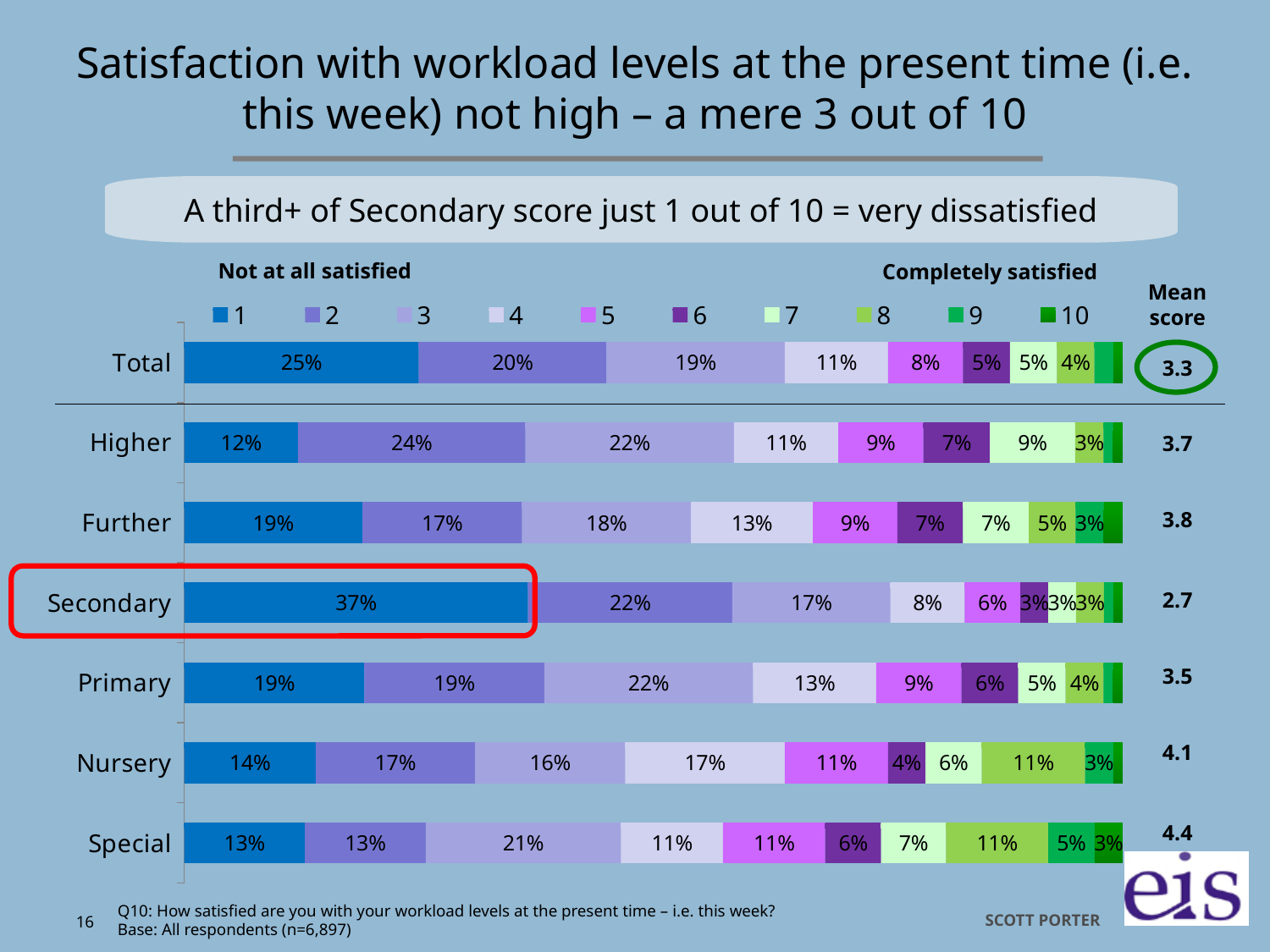
Which category has the highest percentage scoring 1? Secondary Which category has the lowest percentage scoring 1? Higher What is the mean score for Special? 4.4 How many percentage points higher is the Secondary score-1 share than the Total score-1 share? 12 percentage points What percentage of Nursery respondents gave a score of 8? 11% What kind of chart is shown on the slide? Stacked bar chart What percentage of Secondary respondents gave a score of 1? 37% How many series does the legend list? 10 Which has a larger share scoring 2: Higher or Further? Higher How many categories (bars) are shown in the chart? 7 What percentage of Total respondents gave a score of 1? 25% Which category has the lowest mean score? Secondary